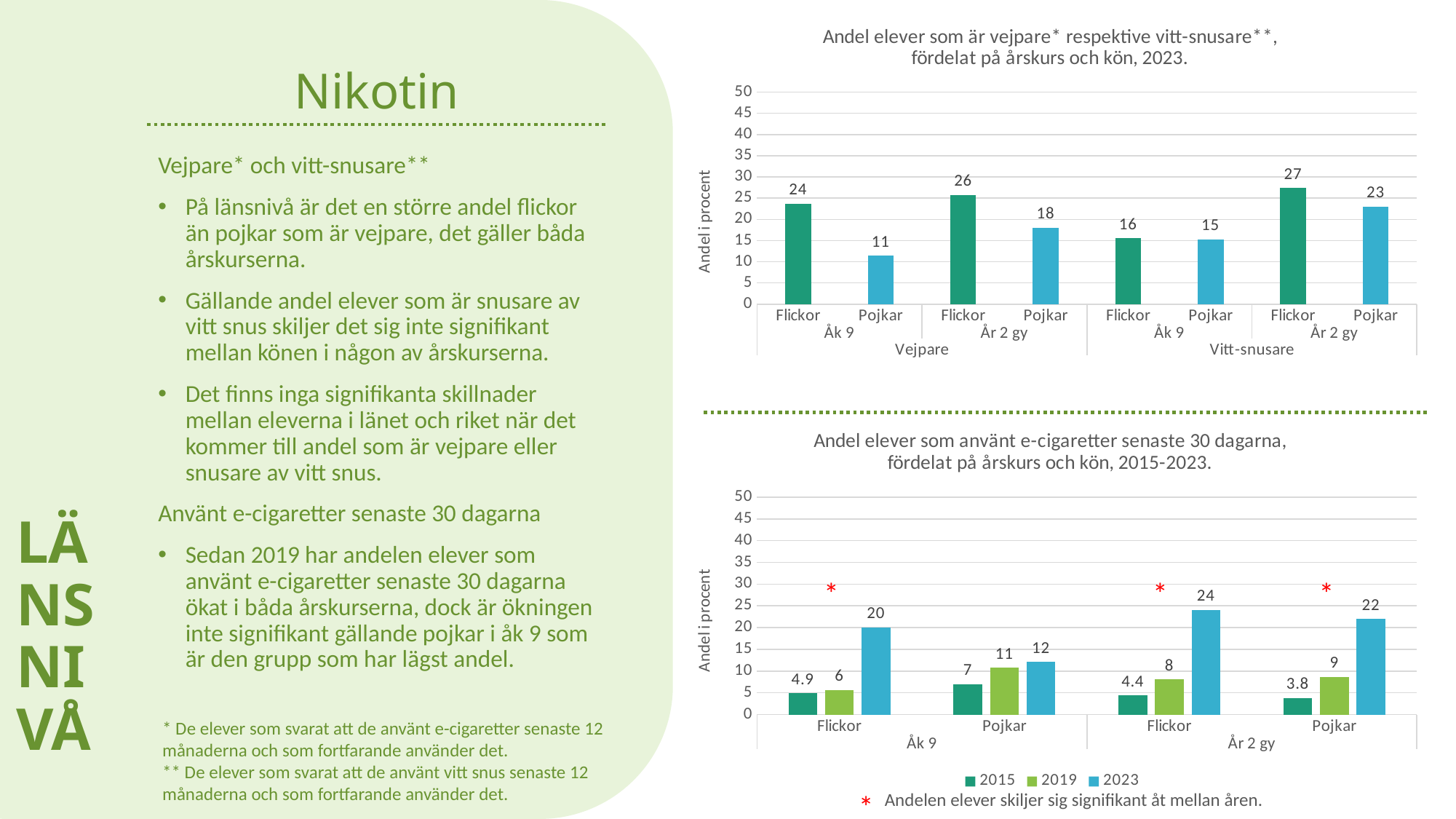
In the top chart, what is the value for Pojkar in Åk 9 under Vejpare? 11 In the bottom chart, do the values for Pojkar in Åk 9 rise or fall from 2015 to 2023? rise In the bottom chart, what is the 2015 value for Flickor in Åk 9? 4.9 In the bottom chart, what is the 2023 value for Pojkar in År 2 gy? 22 In the bottom chart, what is the difference between the 2023 and 2015 values for Flickor in År 2 gy? 19.6 In the top chart, what is the difference between Flickor and Pojkar in Åk 9 under Vejpare? 13 What kind of chart is the bottom chart? bar chart In the bottom chart, which group has the highest 2023 value? Flickor, År 2 gy In the top chart, what is the value for Flickor in År 2 gy under Vitt-snusare? 27 In the top chart, which is larger: Flickor in År 2 gy under Vejpare or Flickor in År 2 gy under Vitt-snusare? Flickor in År 2 gy under Vitt-snusare In the top chart, which bar has the lowest value? Pojkar, Åk 9, Vejpare In the bottom chart, how many series does the legend list? 3